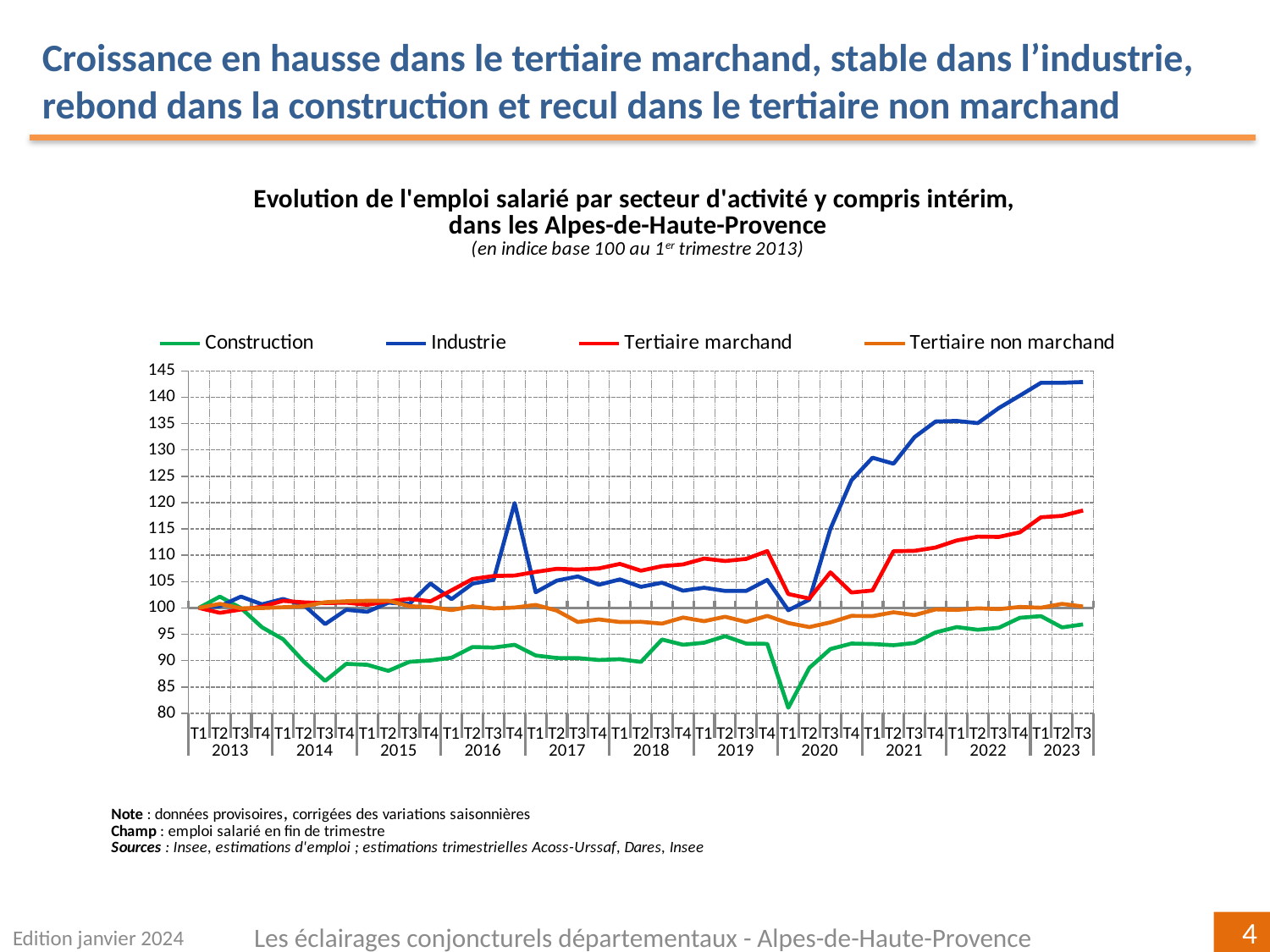
Which series has the lowest value at T3 2023? Construction Is the value for Industrie at T3 2023 greater or less than 140? greater Which series has the highest value at T3 2023? Industrie How many series does the legend list? 4 Is the value for Industrie at T4 2016 greater or less than 115? greater Which series is shown in blue in the legend? Industrie How many years are labelled along the x axis? 11 What kind of chart is shown on the slide? line chart Is the value for Construction at T1 2020 greater or less than 85? less At T3 2023, which is larger: the value for Industrie or the value for Construction? Industrie Does the Industrie series rise or fall between T1 2020 and T3 2023? rise